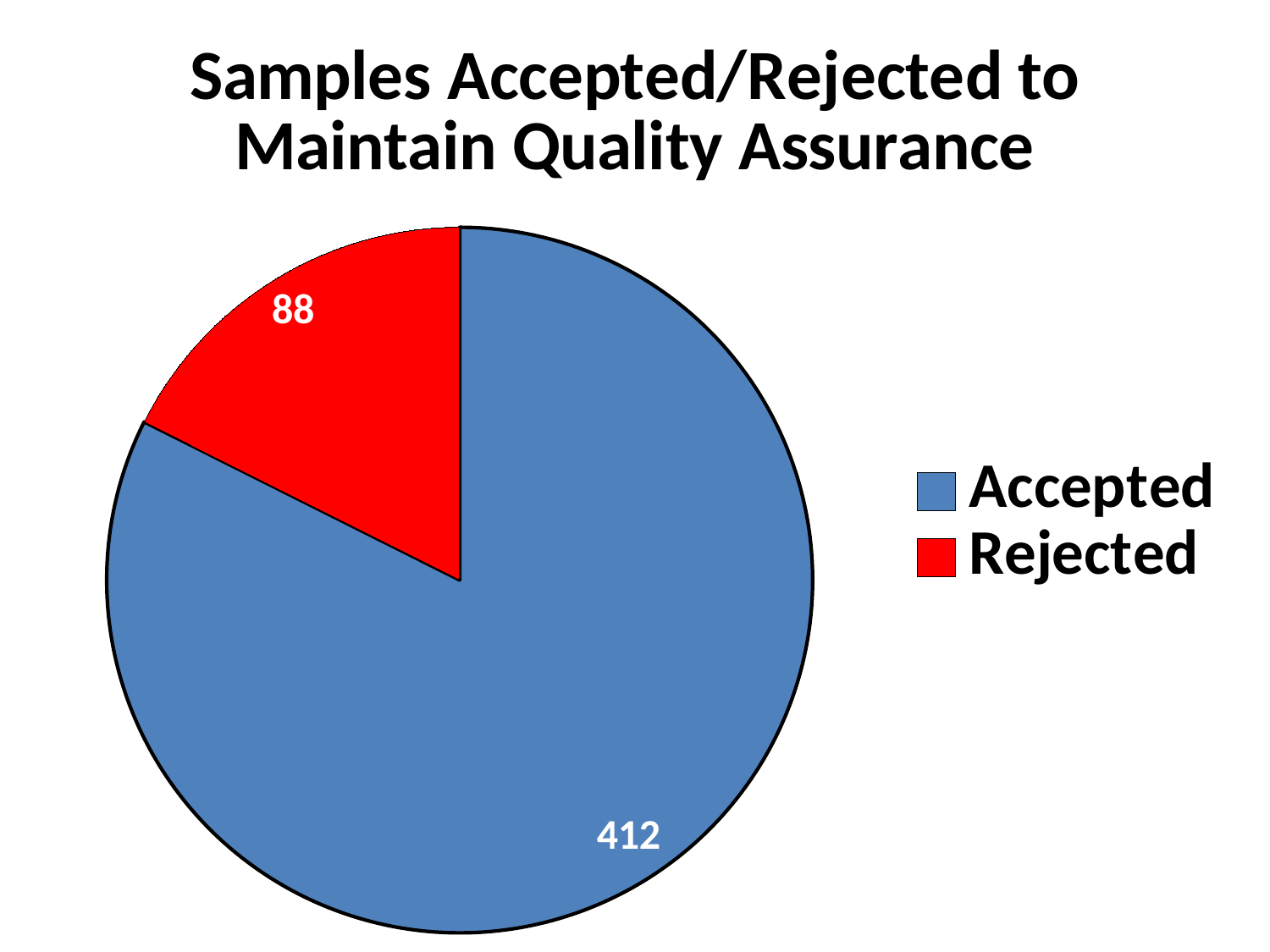
What kind of chart is shown? Pie chart Which is larger, Accepted or Rejected? Accepted Which category has the smallest slice? Rejected How many slices does the pie chart have? 2 How many entries does the legend list? 2 What is the value for Rejected? 88 What is the value for Accepted? 412 What is the difference between the Accepted and Rejected values? 324 What is the total of all slices in the pie? 500 Which category has the largest slice? Accepted What share of the pie does the Rejected slice represent? 17.6% What colour is the Rejected slice? Red